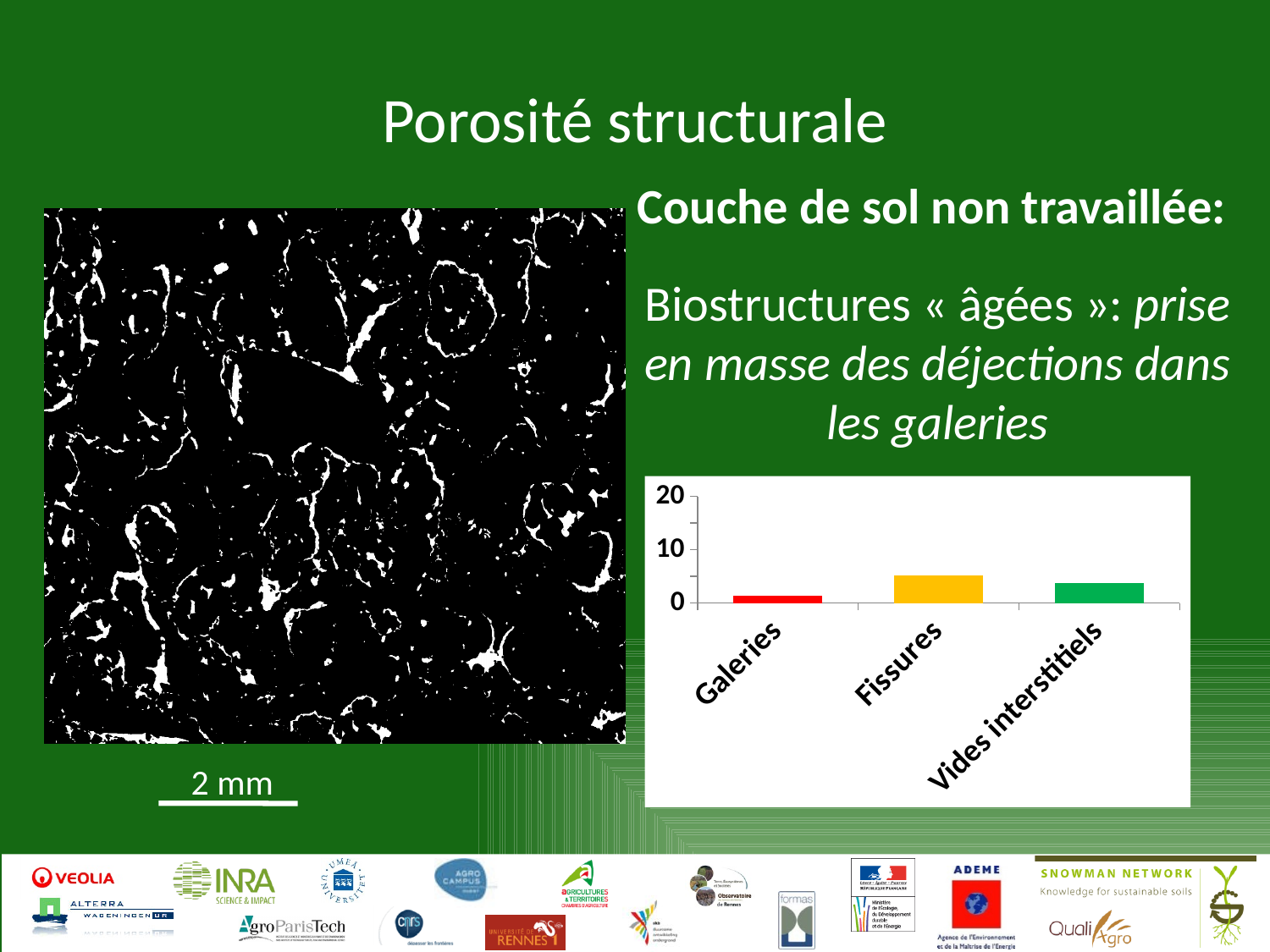
Is the value for Vides interstitiels greater or less than 10? less What colour is the bar for Galeries? red Which category has the highest bar on the chart? Fissures Which category has the lowest bar on the chart? Galeries Is the value for Galeries greater or less than 10? less Is the value for Fissures greater or less than 10? less How many categories are plotted on the bar chart? 3 Which is larger on the chart, the value for Galeries or the value for Vides interstitiels? Vides interstitiels What is the highest value shown on the chart's vertical axis? 20 What kind of chart is shown on the slide? bar chart Which is larger on the chart, the value for Galeries or the value for Fissures? Fissures